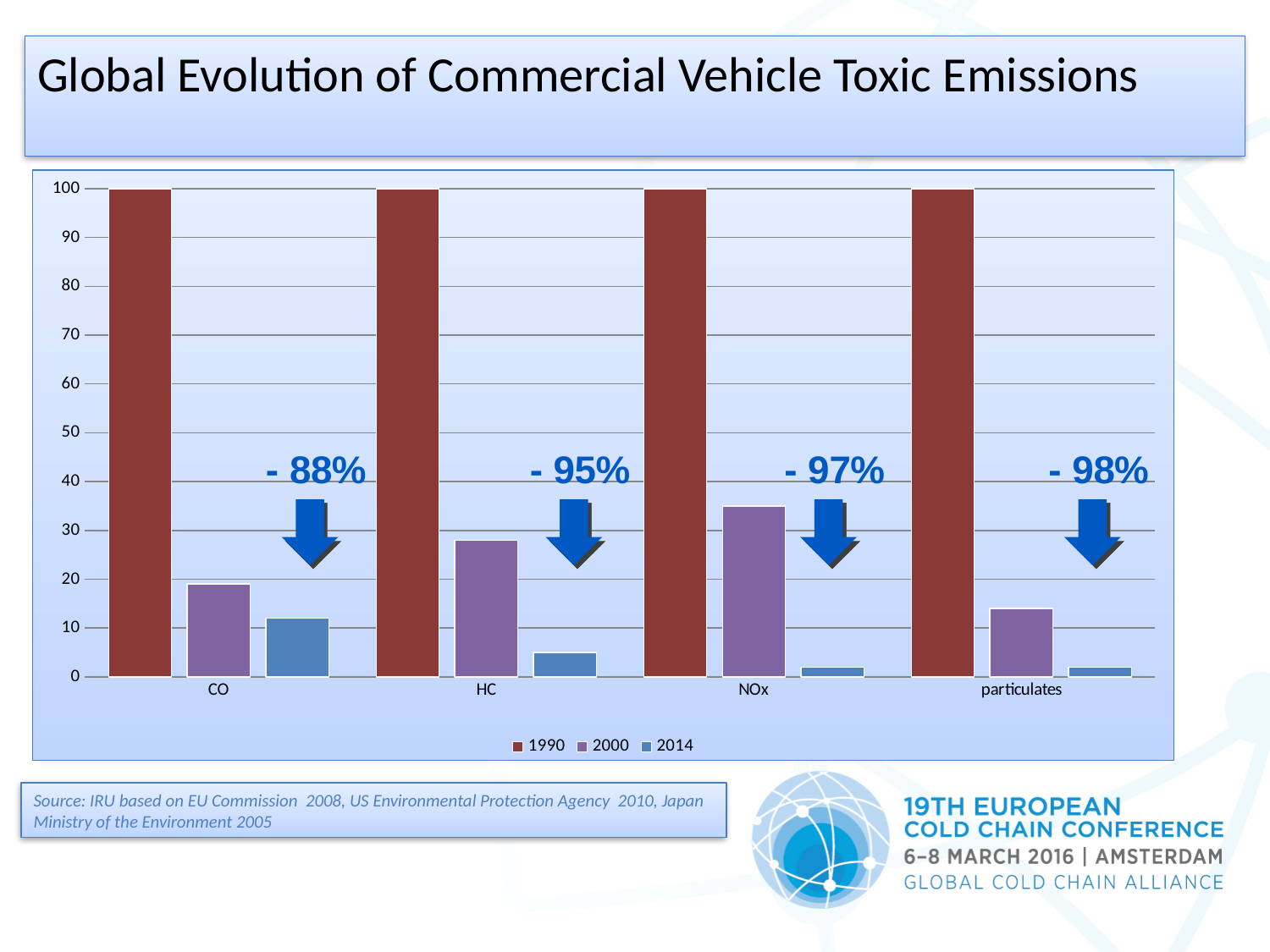
What percentage reduction is annotated above the NOx bars? - 97% Is the 2000 value for HC greater or less than 20? greater What is the value of the 1990 bar for CO? 100 How many emission categories are shown on the x axis? 4 Which category has the highest 2000 value? NOx Is the 2014 value for HC greater or less than 10? less How many series does the legend list? 3 Is the 2000 value for NOx greater or less than 30? greater Do the values for CO rise or fall from 1990 to 2014? fall Which category has the lowest 2000 value? particulates Which is larger, the 2000 value for CO or the 2000 value for HC? HC What kind of chart is shown on the slide? bar chart